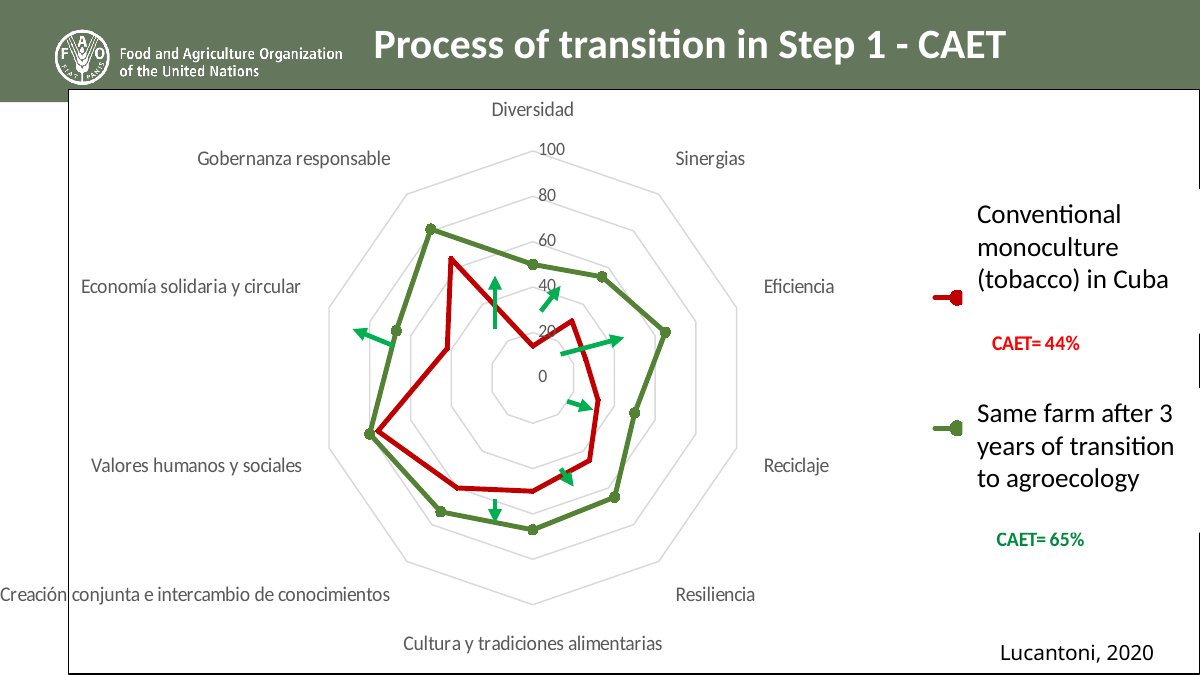
Is the value for Diversidad for the conventional monoculture greater or less than 20? less How many series does the legend list? 2 Which category has the highest value for the conventional monoculture (tobacco) series? Valores humanos y sociales Which series has the larger value for Diversidad, the conventional monoculture or the farm after 3 years of transition? Same farm after 3 years of transition to agroecology How many categories (axes) does the radar chart have? 10 Is the value for Gobernanza responsable for the farm after 3 years of transition greater or less than 60? greater What is the CAET value shown for the conventional monoculture (tobacco) in Cuba? 44% What kind of chart is shown on the slide? Radar chart What is the CAET value shown for the same farm after 3 years of transition to agroecology? 65% Which category has the lowest value for the conventional monoculture (tobacco) series? Diversidad Is the value for Economía solidaria y circular for the conventional monoculture greater or less than 60? less